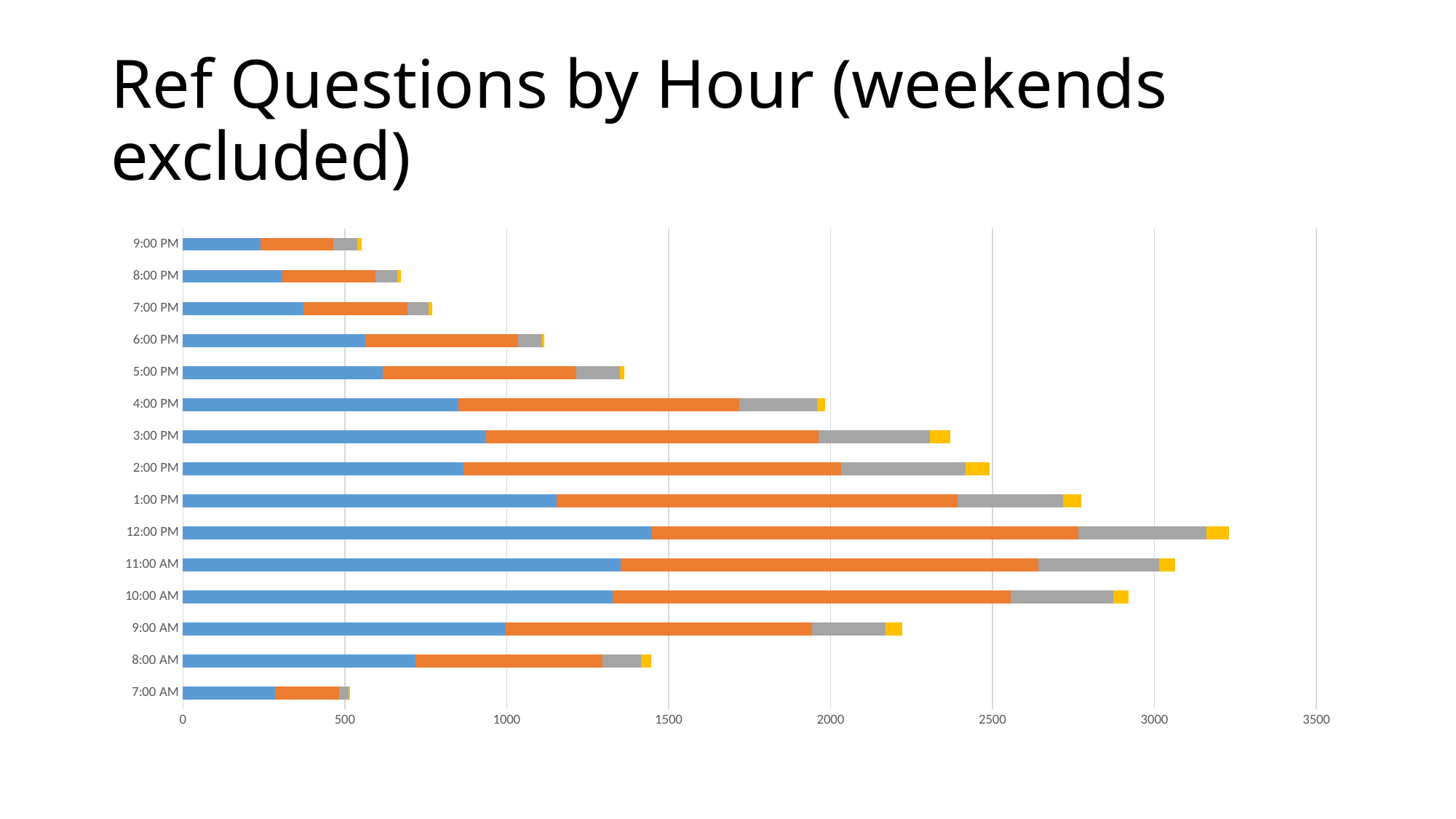
What is the title of the slide containing the chart? Ref Questions by Hour (weekends excluded) Do the total bar lengths rise or fall from 12:00 PM through 9:00 PM? fall Which has the longer total bar, 2:00 PM or 3:00 PM? 2:00 PM Is the total bar for 5:00 PM greater or less than 1500? less Is the total bar for 9:00 AM greater or less than 2000? greater What kind of chart is shown on the slide? Stacked bar chart How many hourly categories are plotted on the chart? 15 Which has the longer total bar, 11:00 AM or 10:00 AM? 11:00 AM Is the total bar for 12:00 PM greater or less than 3000? greater Which hour has the longest total bar? 12:00 PM